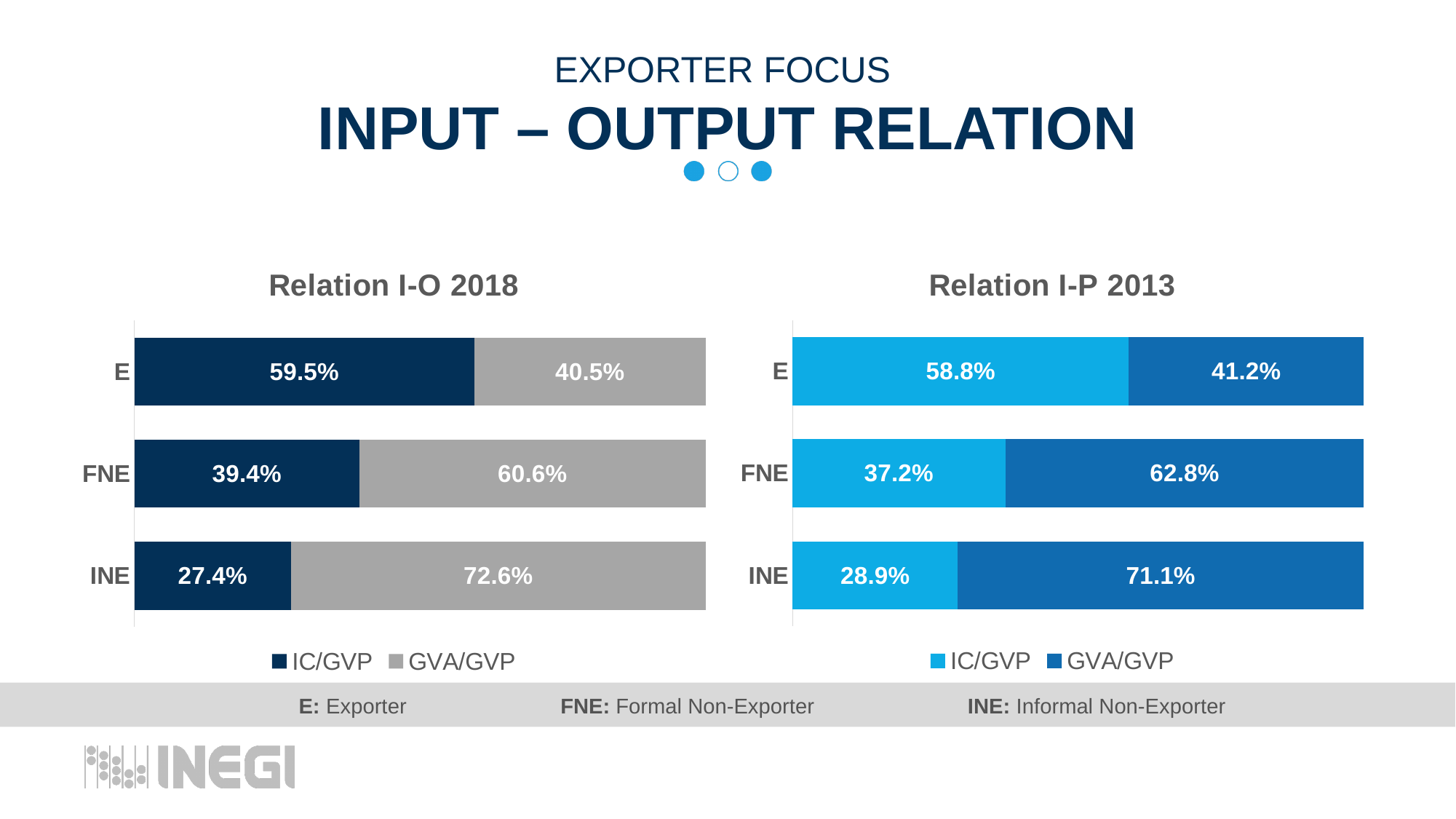
In the 'Relation I-O 2018' chart, what is the IC/GVP value for E? 59.5% In the 'Relation I-P 2013' chart, which category has the lowest IC/GVP value? INE How many categories are shown in the 'Relation I-O 2018' chart? 3 In the 'Relation I-O 2018' chart, which category has the highest IC/GVP value? E In the 'Relation I-O 2018' chart, what is the difference between the GVA/GVP values for INE and E? 32.1% In the 'Relation I-P 2013' chart, what is the total of the stacked bar for INE? 100% In the 'Relation I-P 2013' chart, which is larger: the IC/GVP value for FNE or the IC/GVP value for INE? FNE In the 'Relation I-P 2013' chart, what is the IC/GVP value for FNE? 37.2% In the 'Relation I-O 2018' chart, what is the GVA/GVP value for INE? 72.6% How many series does the legend of the 'Relation I-P 2013' chart list? 2 In the 'Relation I-P 2013' chart, what is the GVA/GVP value for E? 41.2% What kind of chart is the 'Relation I-O 2018' chart? Stacked bar chart